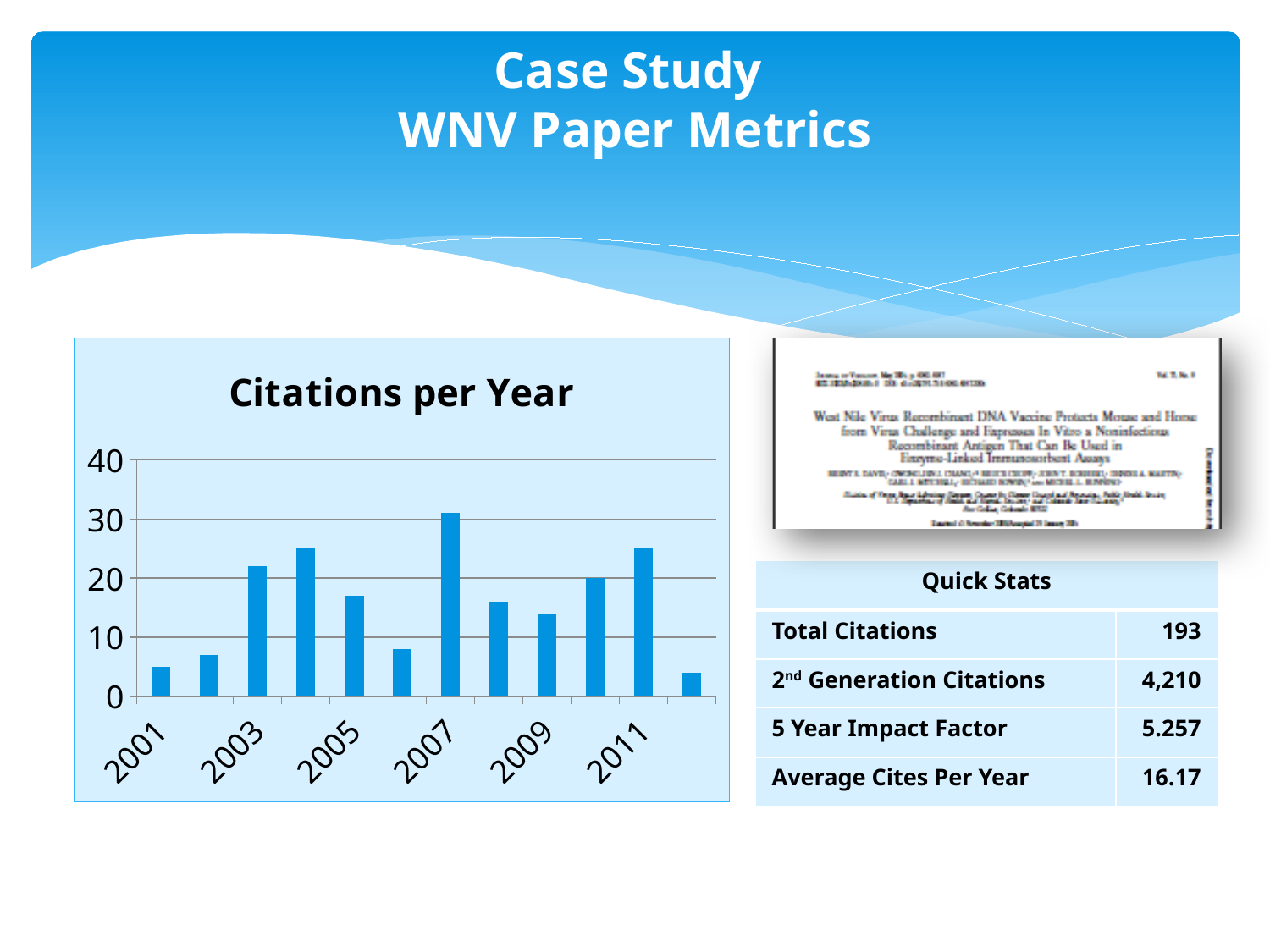
In the 'Citations per Year' chart, which year has more citations, 2007 or 2009? 2007 How many bars (years) are plotted in the 'Citations per Year' chart? 12 Which year has the highest number of citations in the 'Citations per Year' chart? 2007 Is the value for 2011 greater or less than 20 in the 'Citations per Year' chart? greater What kind of chart is the 'Citations per Year' chart? bar chart What is the highest value shown on the vertical axis of the 'Citations per Year' chart? 40 Is the value for 2007 greater or less than 20 in the 'Citations per Year' chart? greater Is the value for 2009 greater or less than 20 in the 'Citations per Year' chart? less What is the title of the chart on the slide? Citations per Year In the 'Citations per Year' chart, which year has more citations, 2001 or 2003? 2003